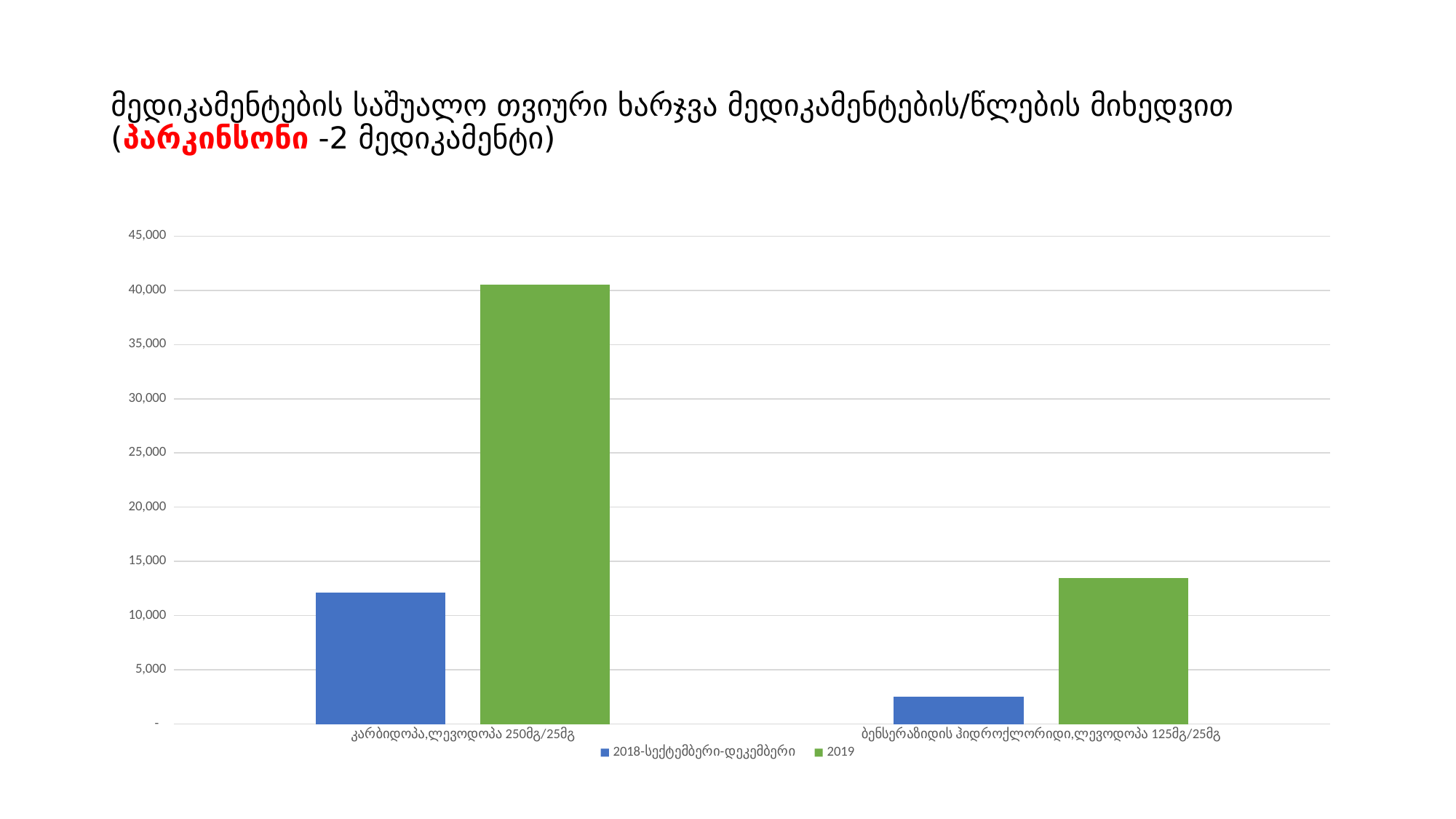
Is the 2018-სექტემბერი-დეკემბერი value for ბენსერაზიდის ჰიდროქლორიდი,ლევოდოპა 125მგ/25მგ greater or less than 5,000? less What kind of chart is shown on the slide? bar chart How many categories are shown on the x axis of the chart? 2 Which category has the tallest bar in the chart? კარბიდოპა,ლევოდოპა 250მგ/25მგ For ბენსერაზიდის ჰიდროქლორიდი,ლევოდოპა 125მგ/25მგ, which series is larger: 2018-სექტემბერი-დეკემბერი or 2019? 2019 Is the 2019 value for ბენსერაზიდის ჰიდროქლორიდი,ლევოდოპა 125მგ/25მგ greater or less than 10,000? greater What colour represents the 2019 series in the chart? green Which series has the lowest bar in the chart? 2018-სექტემბერი-დეკემბერი for ბენსერაზიდის ჰიდროქლორიდი,ლევოდოპა 125მგ/25მგ How many series does the chart's legend list? 2 For კარბიდოპა,ლევოდოპა 250მგ/25მგ, which series is larger: 2018-სექტემბერი-დეკემბერი or 2019? 2019 Is the 2018-სექტემბერი-დეკემბერი value for კარბიდოპა,ლევოდოპა 250მგ/25მგ greater or less than 15,000? less